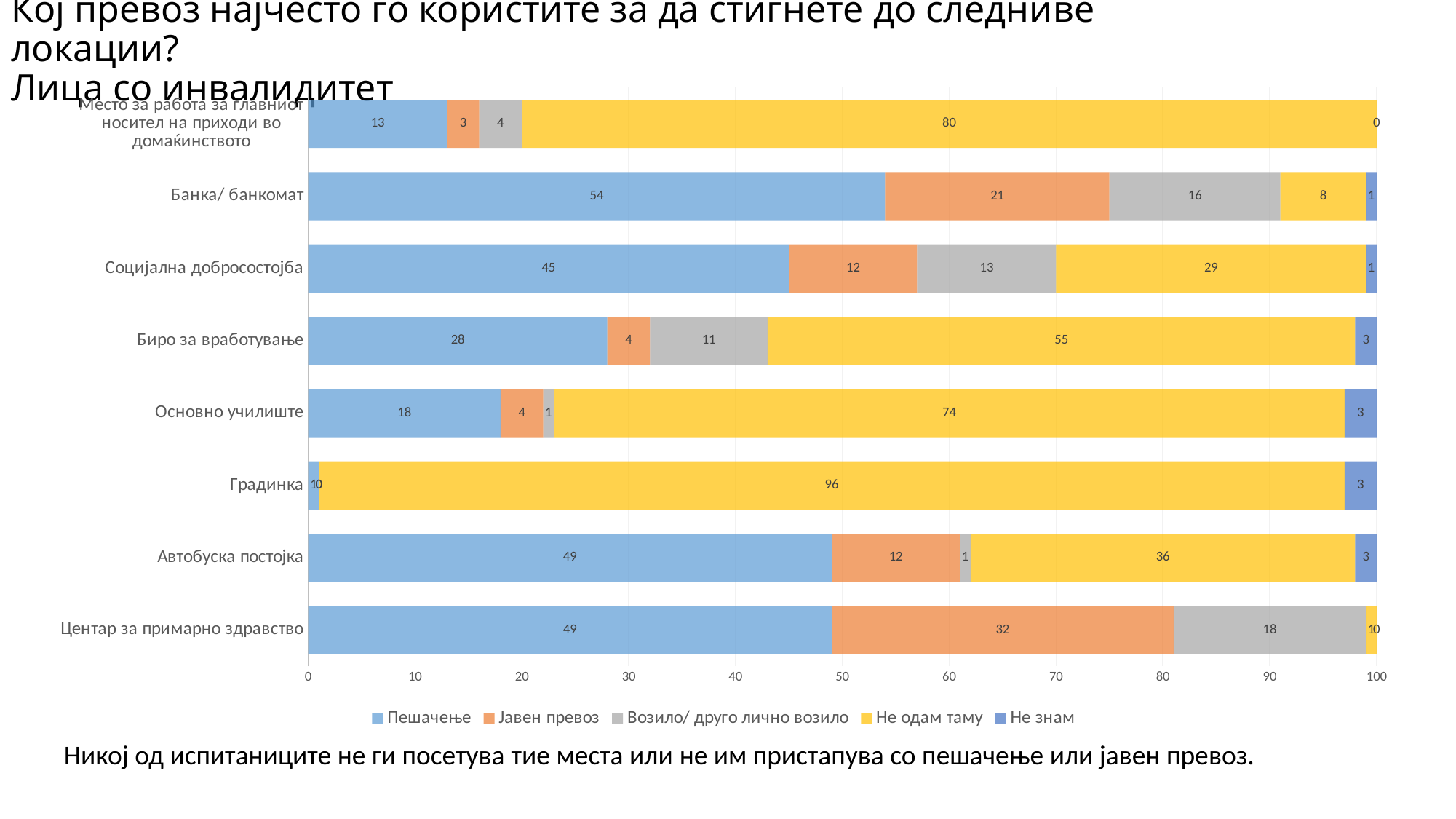
What kind of chart is shown on the slide? Stacked bar chart What is the total of the stacked bar for Банка/ банкомат? 100 Which category has the highest value for Не одам таму? Градинка How many series does the legend list? 5 What is the value for Не одам таму for Градинка? 96 What is the value for Јавен превоз for Центар за примарно здравство? 32 How many categories are shown on the chart? 8 What is the value for Пешачење for Банка/ банкомат? 54 Which category has the highest value for Пешачење? Банка/ банкомат What is the difference between the Пешачење values for Банка/ банкомат and Социјална добросостојба? 9 Which has the larger Јавен превоз value: Банка/ банкомат or Центар за примарно здравство? Центар за примарно здравство What is the value for Возило/ друго лично возило for Социјална добросостојба? 13